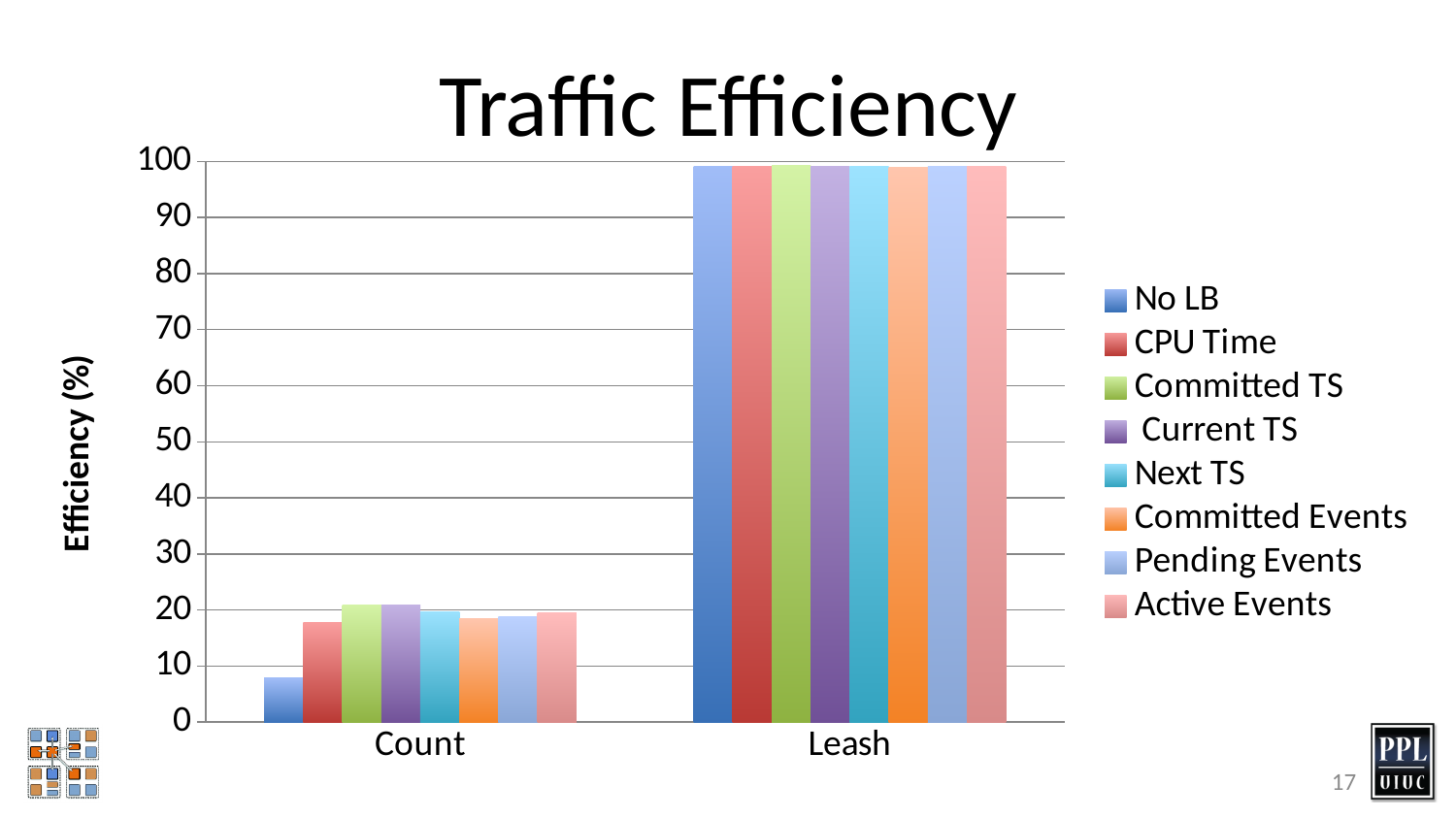
How many categories are shown on the x axis of the chart? 2 What is the label on the vertical axis of the chart? Efficiency (%) What kind of chart is shown on the slide? bar chart For the No LB series, which category has the higher value: Count or Leash? Leash Is the value for No LB in the Leash category greater or less than 90? greater How many series does the legend list? 8 Which series has the lowest value in the Count category? No LB In the Count category, which is larger: the value for No LB or the value for CPU Time? CPU Time What is the title of the chart? Traffic Efficiency Is the value for Committed TS in the Count category greater or less than 30? less Is the value for CPU Time in the Count category greater or less than 10? greater